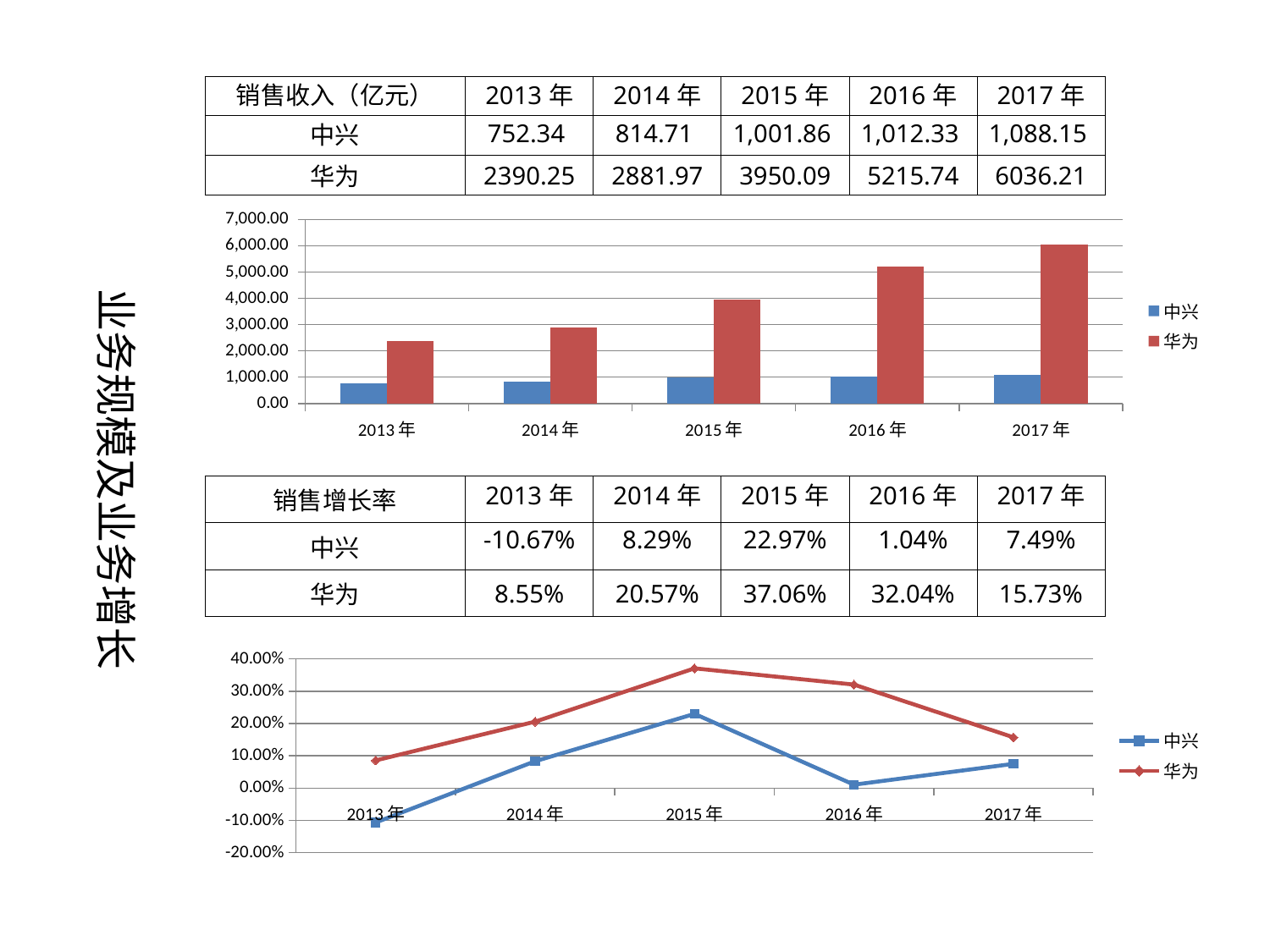
How many series does the legend of the top bar chart list? 2 In the bottom line chart, which year has the highest growth rate for 华为? 2015年 In the top bar chart, which year has the highest value for 华为? 2017年 What kind of chart is the top chart on the slide? bar chart How many years are shown on the x axis of the bottom line chart? 5 In the top bar chart, is the value for 华为 in 2016年 greater or less than 5,000.00? greater In the bottom line chart, what is the growth rate of 中兴 in 2013年? -10.67% In the top bar chart, what is the sales revenue of 华为 in 2017年? 6036.21 In the bottom line chart, which is larger in 2016年, the growth rate of 中兴 or 华为? 华为 In the top bar chart, which year has the lowest value for 中兴? 2013年 In the top bar chart, what is the sales revenue of 中兴 in 2015年? 1,001.86 What kind of chart is the bottom chart on the slide? line chart